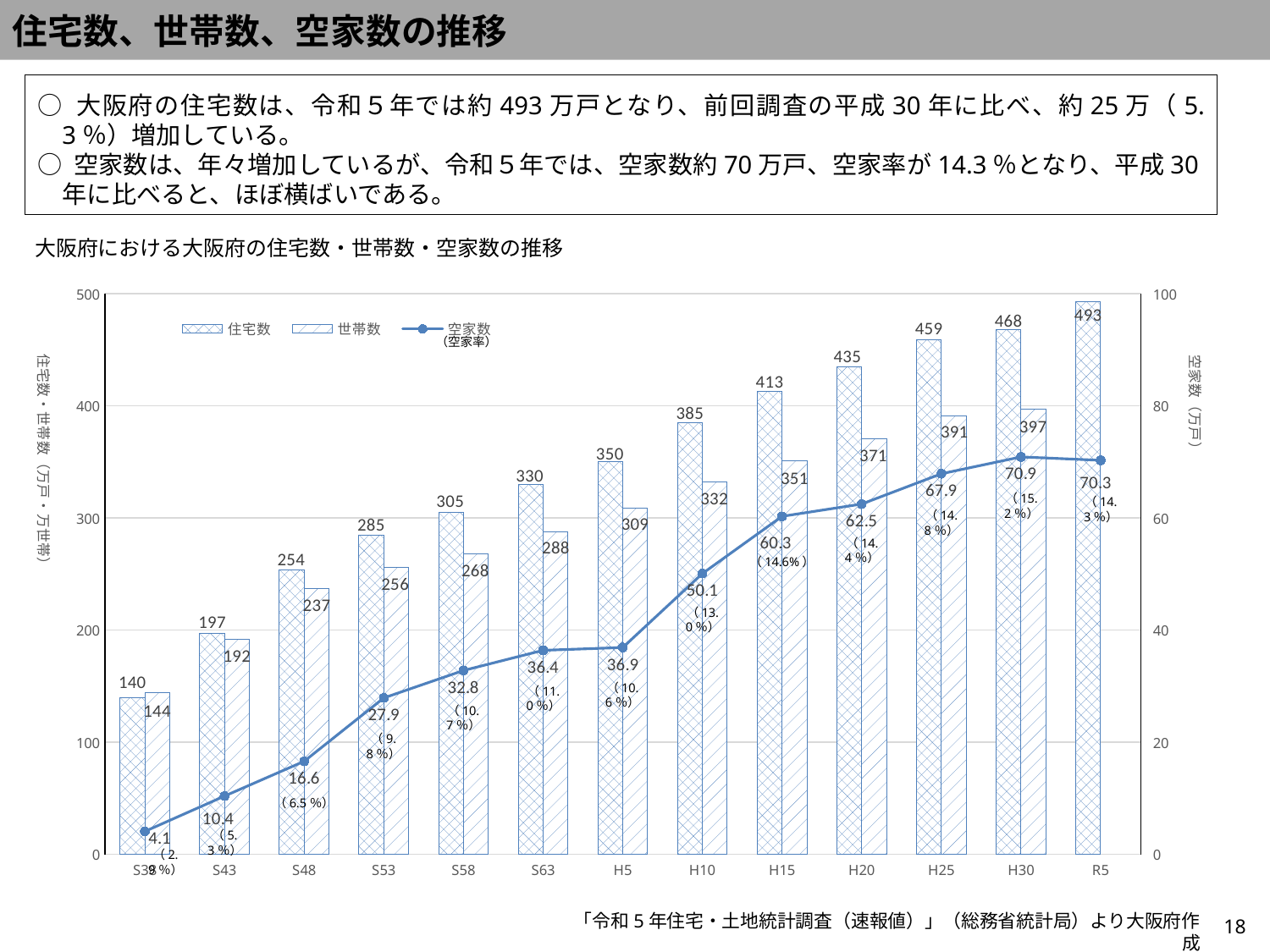
What is the 空家数 value for H15? 60.3 What 空家率 is shown for H30? 15.2% Does the 住宅数 rise or fall from S38 to R5? Rise What is the difference between the 住宅数 for R5 and for H30? 25 Which year has the highest 住宅数? R5 What is the 世帯数 value for H30? 397 Which is larger, the 世帯数 for H20 or the 世帯数 for H15? H20 How many series does the legend list? 3 What kind of chart is this? Combined bar and line chart Which year has the lowest 空家数? S38 How many years are shown on the x axis? 13 What is the 住宅数 value for R5? 493